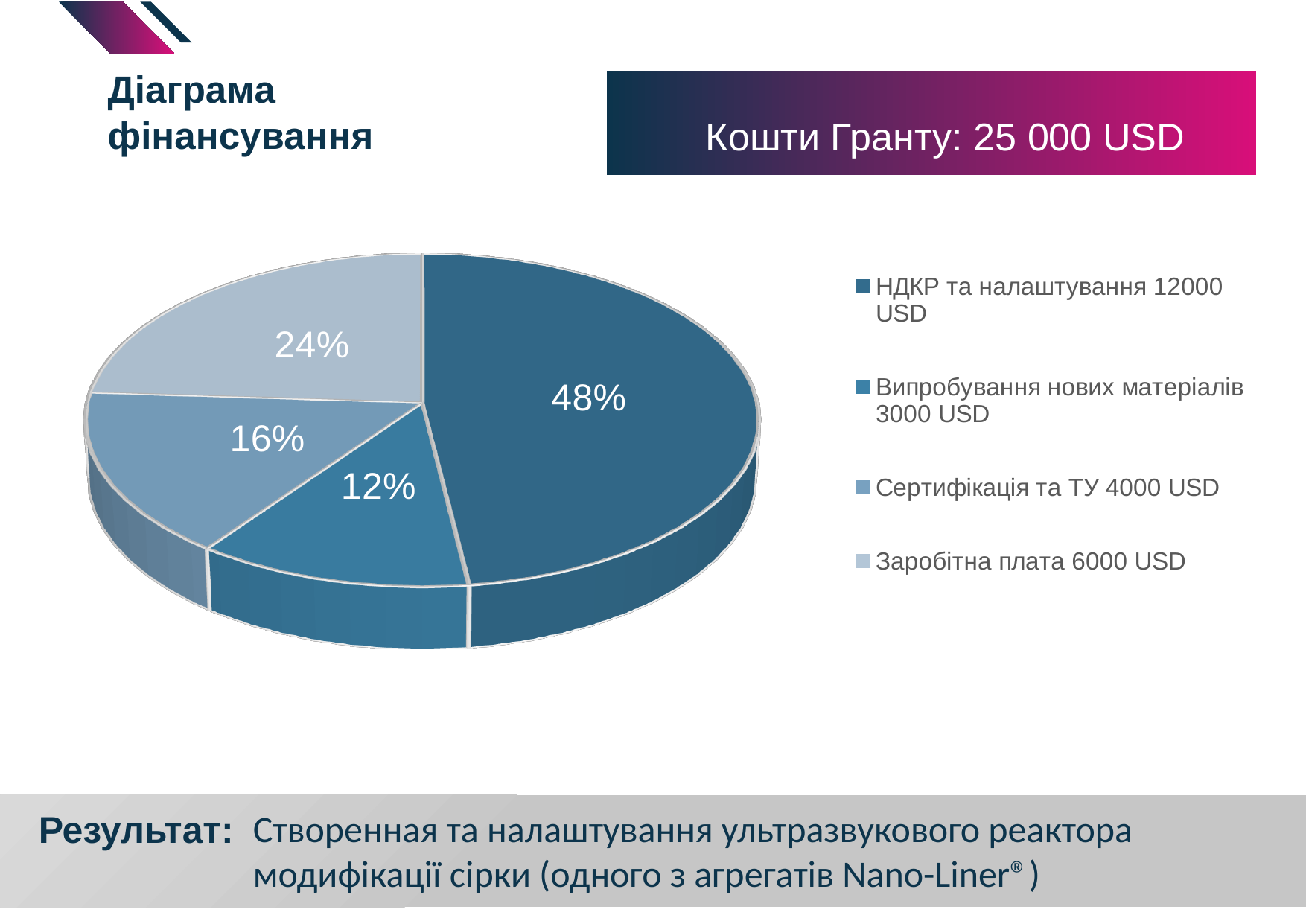
What share of the pie does the slice for 'НДКР та налаштування 12000 USD' represent? 48% Which slice is larger: 'Сертифікація та ТУ 4000 USD' or 'Заробітна плата 6000 USD'? Заробітна плата 6000 USD How many slices does the pie chart have? 4 What share of the pie does the slice for 'Заробітна плата 6000 USD' represent? 24% What kind of chart is shown on the slide? pie chart What share of the pie does the slice for 'Випробування нових матеріалів 3000 USD' represent? 12% What total grant amount is stated in the banner at the top of the slide? 25 000 USD How many entries does the legend of the pie chart list? 4 What is the difference in percentage points between the 'НДКР та налаштування' slice and the 'Заробітна плата' slice? 24% Which category has the smallest slice of the pie? Випробування нових матеріалів 3000 USD Which category has the largest slice of the pie? НДКР та налаштування 12000 USD